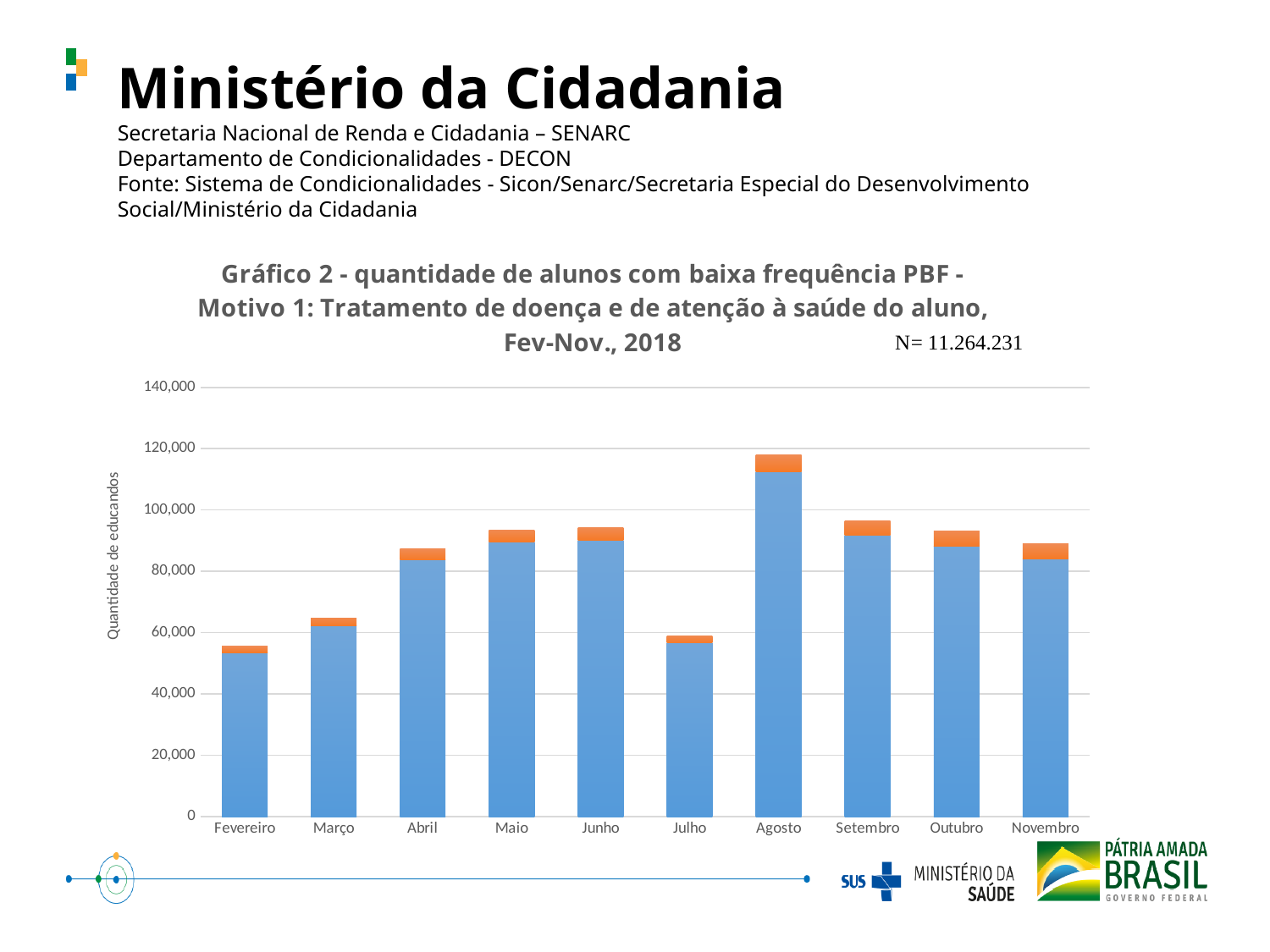
What is the label on the vertical axis of the chart? Quantidade de educandos Which month has the highest bar in the chart? Agosto Is the value for Abril greater or less than 80,000? greater Is the value for Julho greater or less than 80,000? less From Agosto to Novembro, do the bar values rise or fall? fall Is the value for Agosto greater or less than 100,000? greater What kind of chart is shown on the slide? bar chart Which is larger, the bar for Junho or the bar for Julho? Junho How many months are shown on the x axis of the chart? 10 Which is larger, the bar for Agosto or the bar for Setembro? Agosto